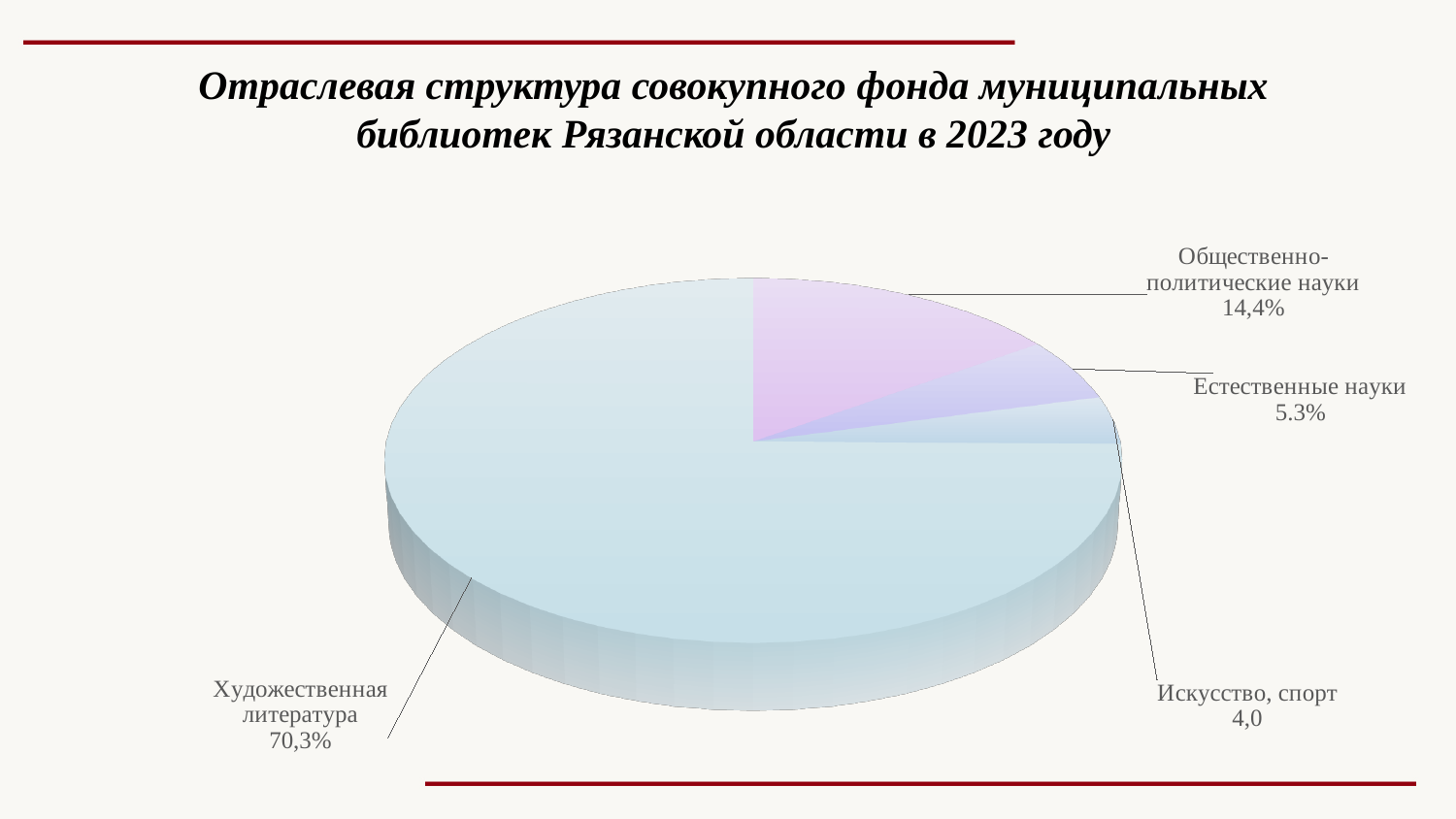
What value is shown for Общественно-политические науки? 14,4% What is the difference between the shares of Художественная литература and Общественно-политические науки? 55,9% What value is shown for Естественные науки? 5.3% Which is larger: Общественно-политические науки or Естественные науки? Общественно-политические науки Which category has the largest slice of the pie? Художественная литература What share of the pie does Художественная литература have? 70,3% What value is shown for Искусство, спорт? 4,0 How many categories are shown in the pie chart? 4 What kind of chart is shown on the slide? Pie chart Which category has the smallest slice of the pie? Искусство, спорт What is the title of the slide? Отраслевая структура совокупного фонда муниципальных библиотек Рязанской области в 2023 году Which year does the chart describe? 2023